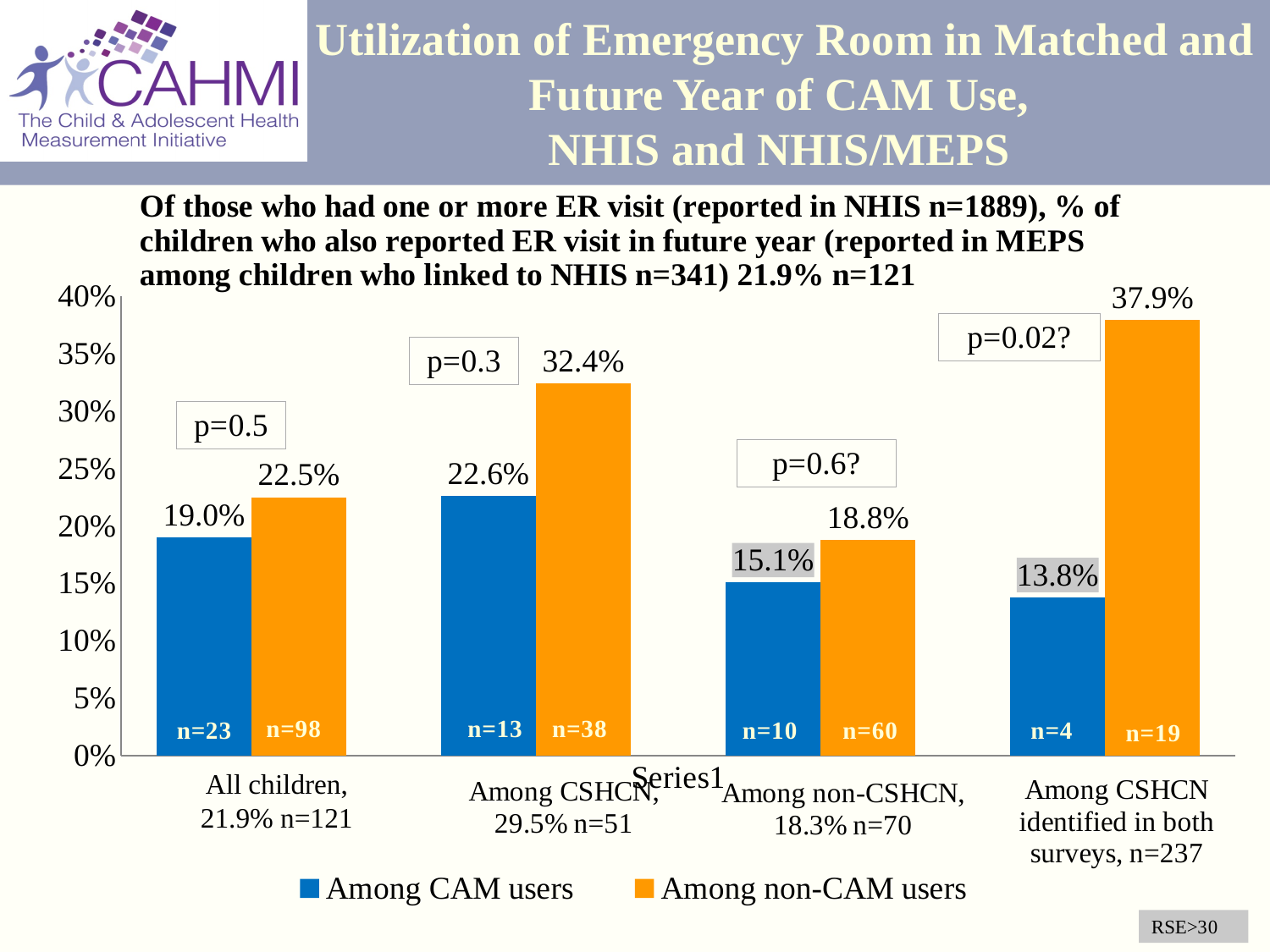
What colour are the bars for Among non-CAM users? Orange What is the value for Among CAM users in the All children category? 19.0% What is the value for Among non-CAM users in the Among CSHCN identified in both surveys category? 37.9% Which category has the lowest value for Among CAM users? Among CSHCN identified in both surveys How many categories are shown on the x axis? 4 What kind of chart is shown on the slide? Bar chart How many series does the legend list? 2 What is the value for Among non-CAM users in the Among CSHCN category? 32.4% In the Among non-CSHCN category, which is larger: Among CAM users or Among non-CAM users? Among non-CAM users What is the value for Among CAM users in the Among non-CSHCN category? 15.1% Which category has the highest value for Among non-CAM users? Among CSHCN identified in both surveys What is the difference between Among non-CAM users and Among CAM users in the Among CSHCN identified in both surveys category? 24.1%